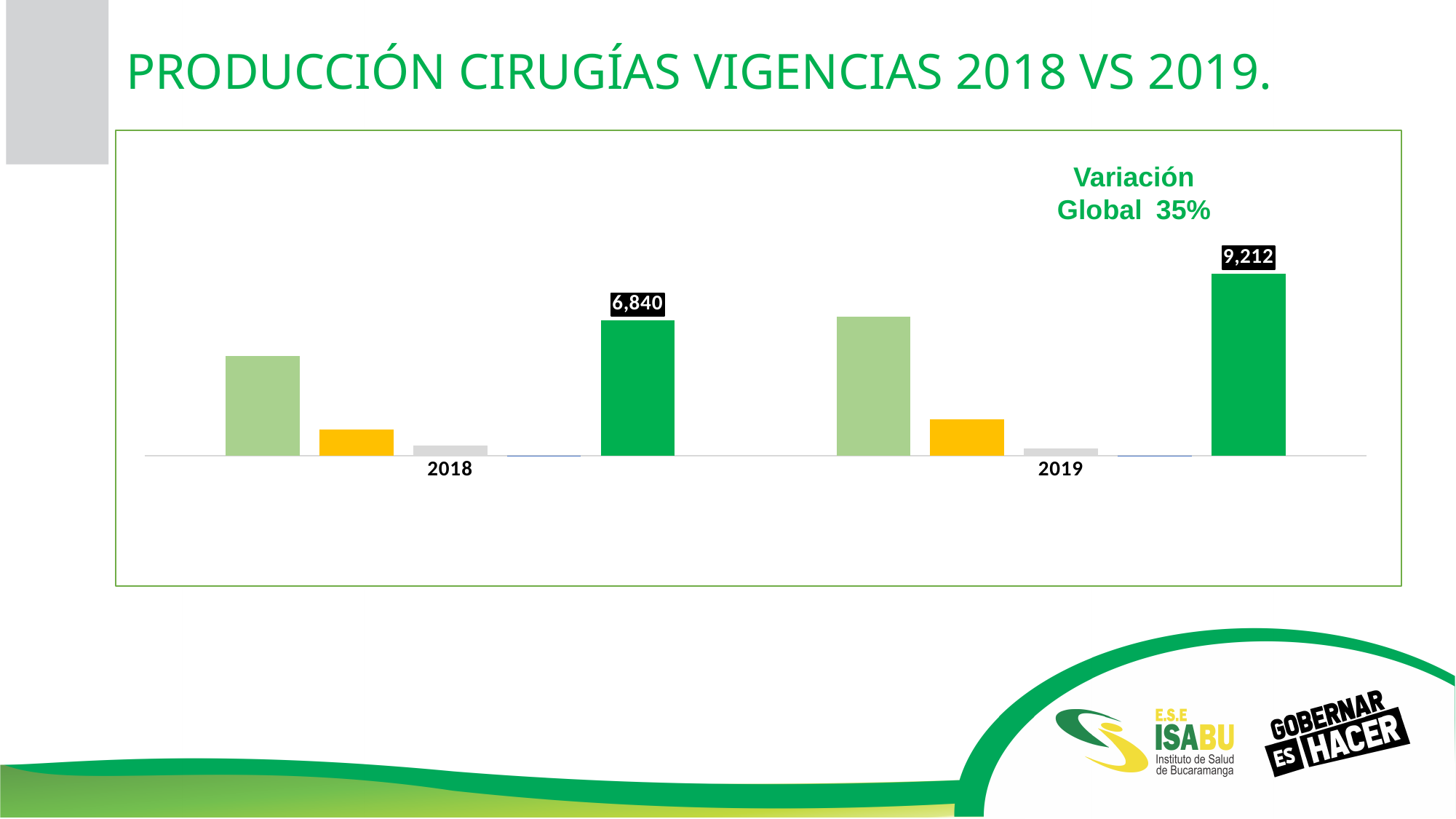
What Variación Global percentage is shown on the chart? 35% Which year has the larger dark green bar, 2018 or 2019? 2019 What is the value of the dark green bar for 2019? 9,212 Does the dark green bar rise or fall from 2018 to 2019? Rise What kind of chart is shown on the slide? Bar chart What is the value of the dark green bar for 2018? 6,840 What is the difference between the dark green bar values for 2019 and 2018? 2,372 What is the title of the slide? PRODUCCIÓN CIRUGÍAS VIGENCIAS 2018 VS 2019. Which year has the taller light green bar, 2018 or 2019? 2019 Within the 2019 group, which coloured bar is the tallest? Dark green How many year categories are shown on the x axis? 2 Within the 2018 group, which coloured bar is the tallest? Dark green